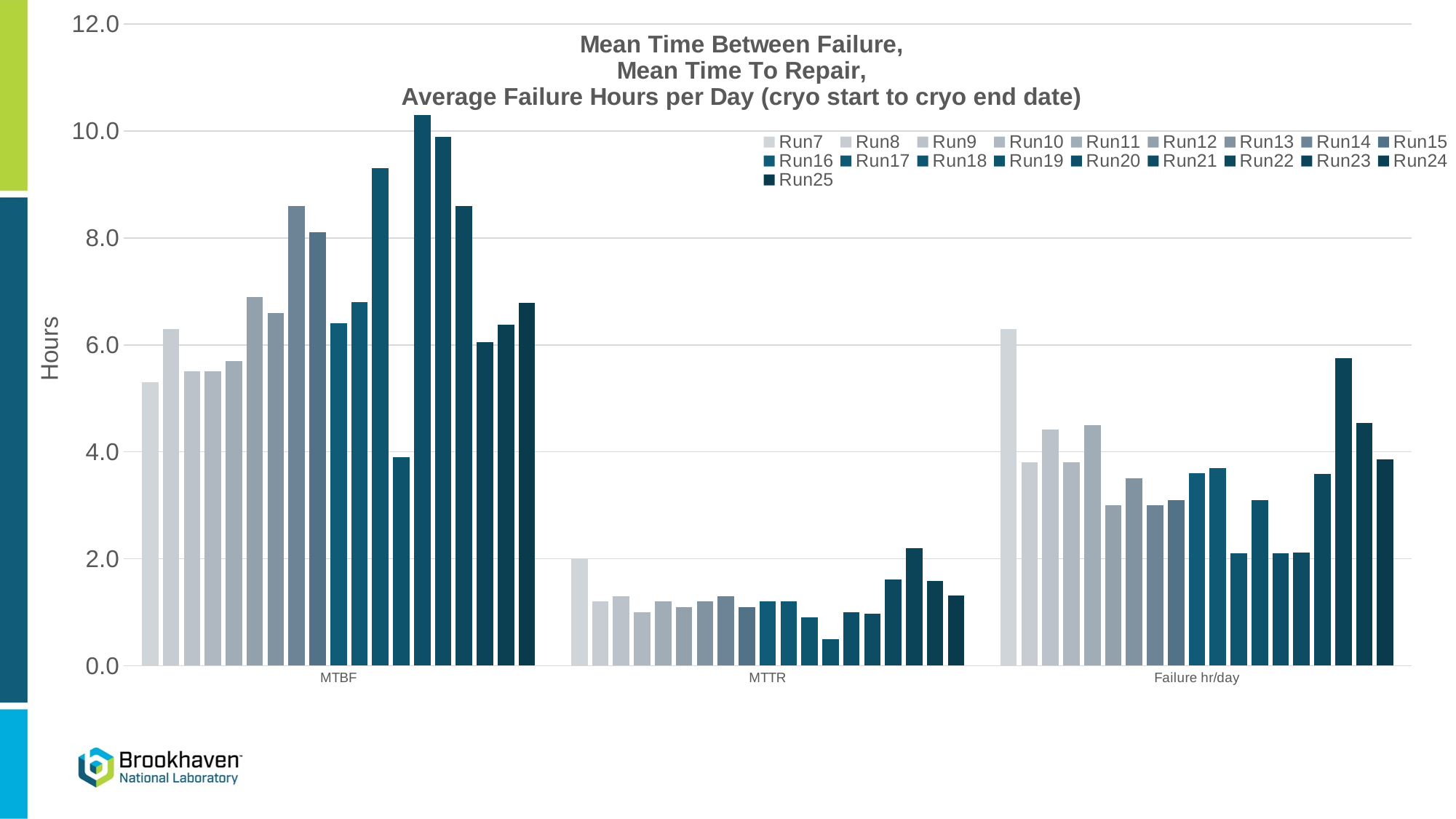
Is the MTBF value for Run20 greater or less than 10.0? greater What kind of chart is shown on the slide? bar chart Which run has the lowest MTTR value in the chart? Run19 What is the label on the vertical axis of the chart? Hours Which is larger, the MTBF value for Run7 or the MTBF value for Run8? Run8 How many series does the chart's legend list? 19 What are the three category labels on the x axis of the chart? MTBF, MTTR, Failure hr/day How many categories are shown on the x axis of the chart? 3 Which run has the highest MTBF value in the chart? Run20 Which category has the tallest bars overall in the chart? MTBF Is the Failure hr/day value for Run7 greater or less than 6.0? greater